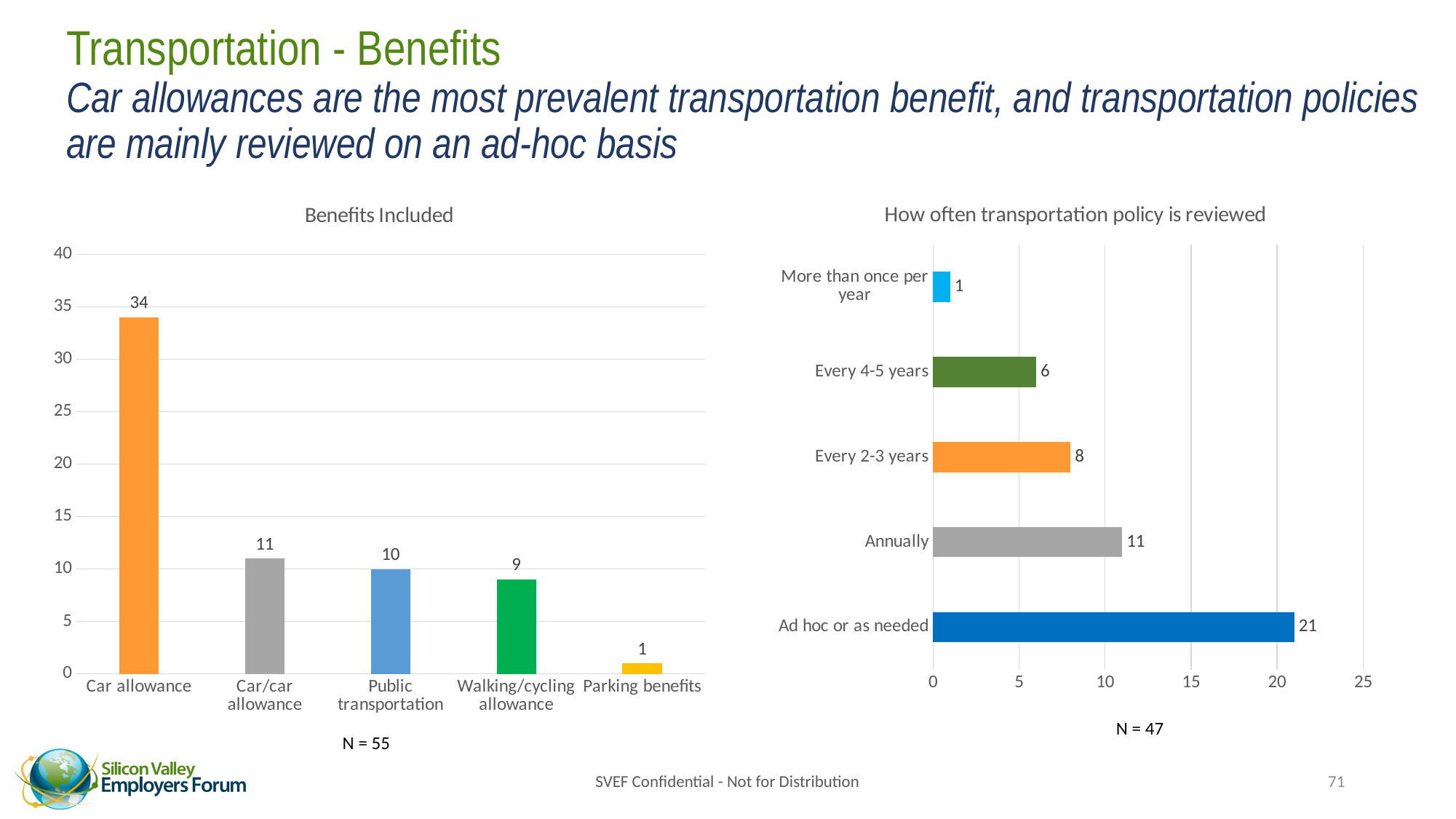
In the 'Benefits Included' chart, how many categories are shown? 5 In the 'How often transportation policy is reviewed' chart, what is the value for Annually? 11 In the 'Benefits Included' chart, is the value for Walking/cycling allowance greater or less than 10? less In the 'How often transportation policy is reviewed' chart, which category has the highest value? Ad hoc or as needed In the 'How often transportation policy is reviewed' chart, what is the difference between Ad hoc or as needed and Annually? 10 In the 'Benefits Included' chart, what is the value for Car allowance? 34 What is the N value shown below the 'How often transportation policy is reviewed' chart? N = 47 In the 'How often transportation policy is reviewed' chart, which is larger: Every 2-3 years or Every 4-5 years? Every 2-3 years What kind of chart is 'How often transportation policy is reviewed'? Bar chart In the 'Benefits Included' chart, which category has the lowest value? Parking benefits In the 'Benefits Included' chart, what is the value for Public transportation? 10 In the 'Benefits Included' chart, what is the difference between Car allowance and Car/car allowance? 23